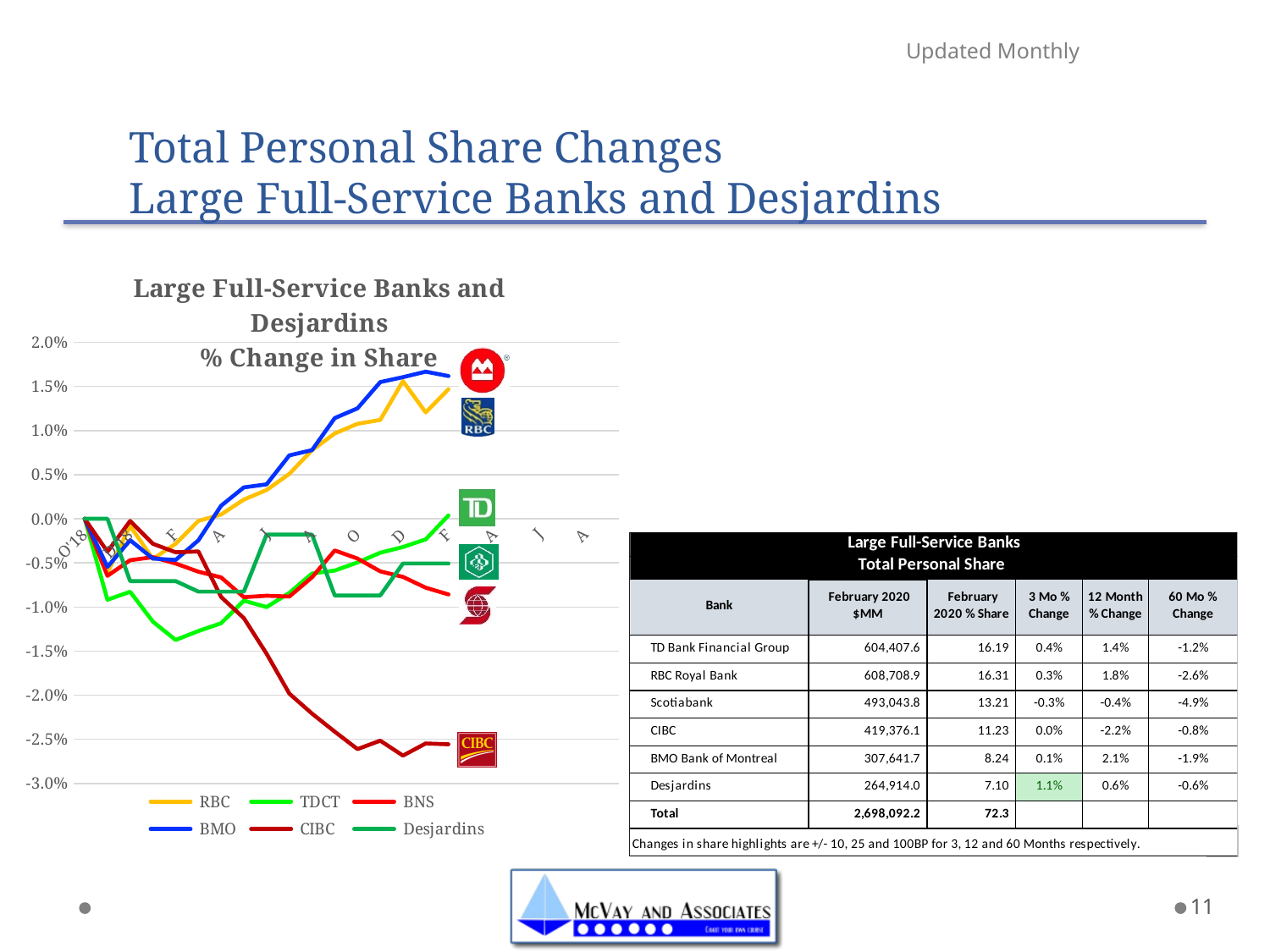
At the right-hand end of the chart, which is higher, the BMO line or the TDCT line? BMO Does the BMO line rise or fall over the period shown? rise How many series does the chart legend list? 6 What is the title of the chart? Large Full-Service Banks and Desjardins % Change in Share Is the final value of the CIBC line greater or less than -2.0%? less Which series has the lowest value at the right-hand end of the chart? CIBC Does the CIBC line rise or fall over the period shown? fall Is the final value of the BNS line greater or less than -0.5%? less Which series are listed in the chart legend? RBC, TDCT, BNS, BMO, CIBC, Desjardins At the right-hand end of the chart, which is lower, the CIBC line or the BNS line? CIBC What kind of chart is shown on the slide? line chart Is the final value of the BMO line greater or less than 1.0%? greater